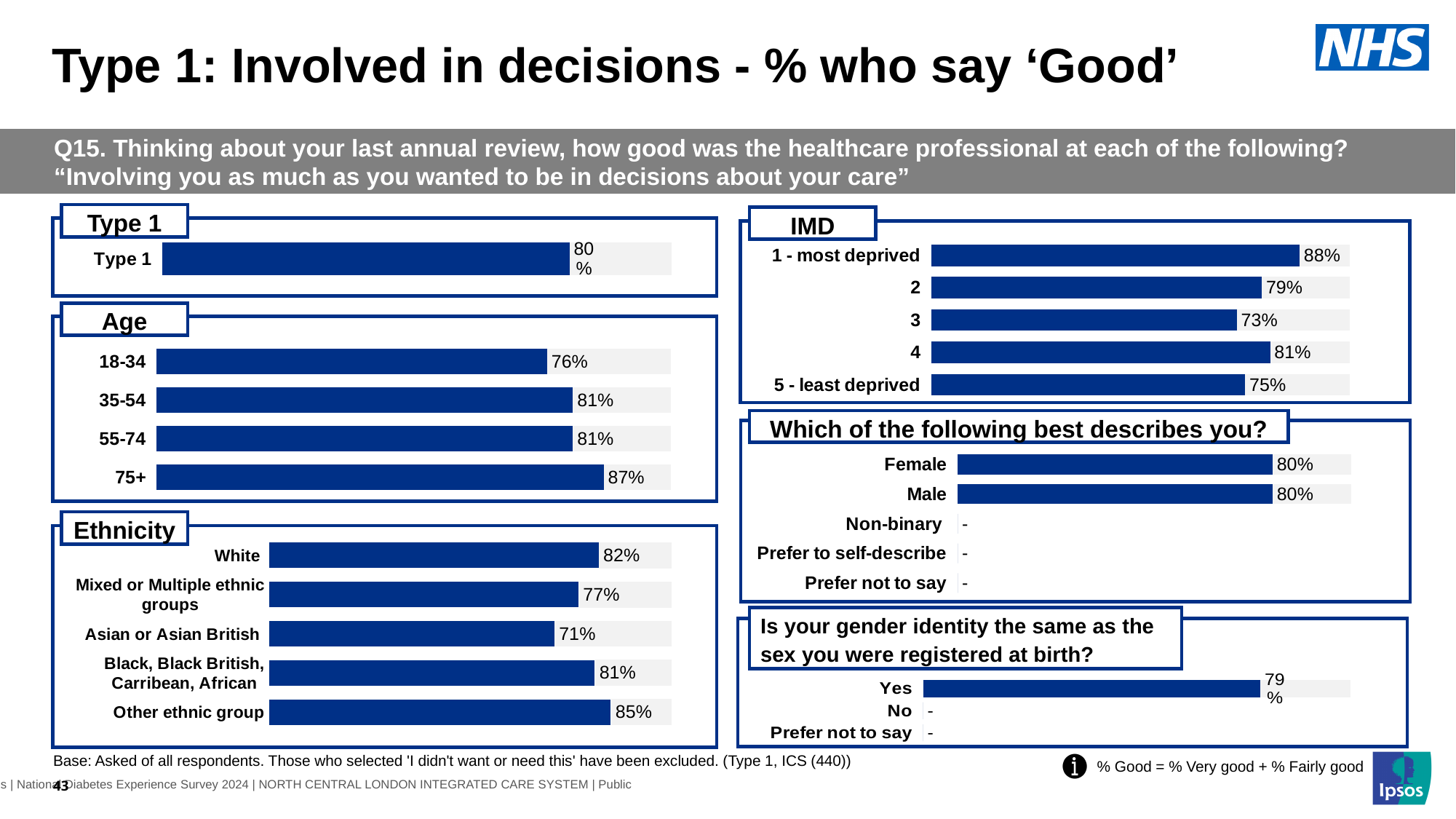
In the Type 1 chart, what is the value for Type 1? 80% In the Ethnicity chart, how many ethnic groups are shown? 5 In the Age chart, what is the difference between the values for 75+ and 18-34? 11 percentage points In the IMD chart, which is larger, the value for 4 or the value for 5 - least deprived? 4 In the Age chart, what is the value for 18-34? 76% In the 'Which of the following best describes you?' chart, what is the value for Female? 80% What kind of chart is used in the 'Is your gender identity the same as the sex you were registered at birth?' section? Bar chart In the Ethnicity chart, which group has the lowest value? Asian or Asian British In the IMD chart, which category has the highest value? 1 - most deprived In the IMD chart, what is the value for 3? 73% In the Ethnicity chart, what is the value for Other ethnic group? 85% In the Age chart, which age group has the highest value? 75+